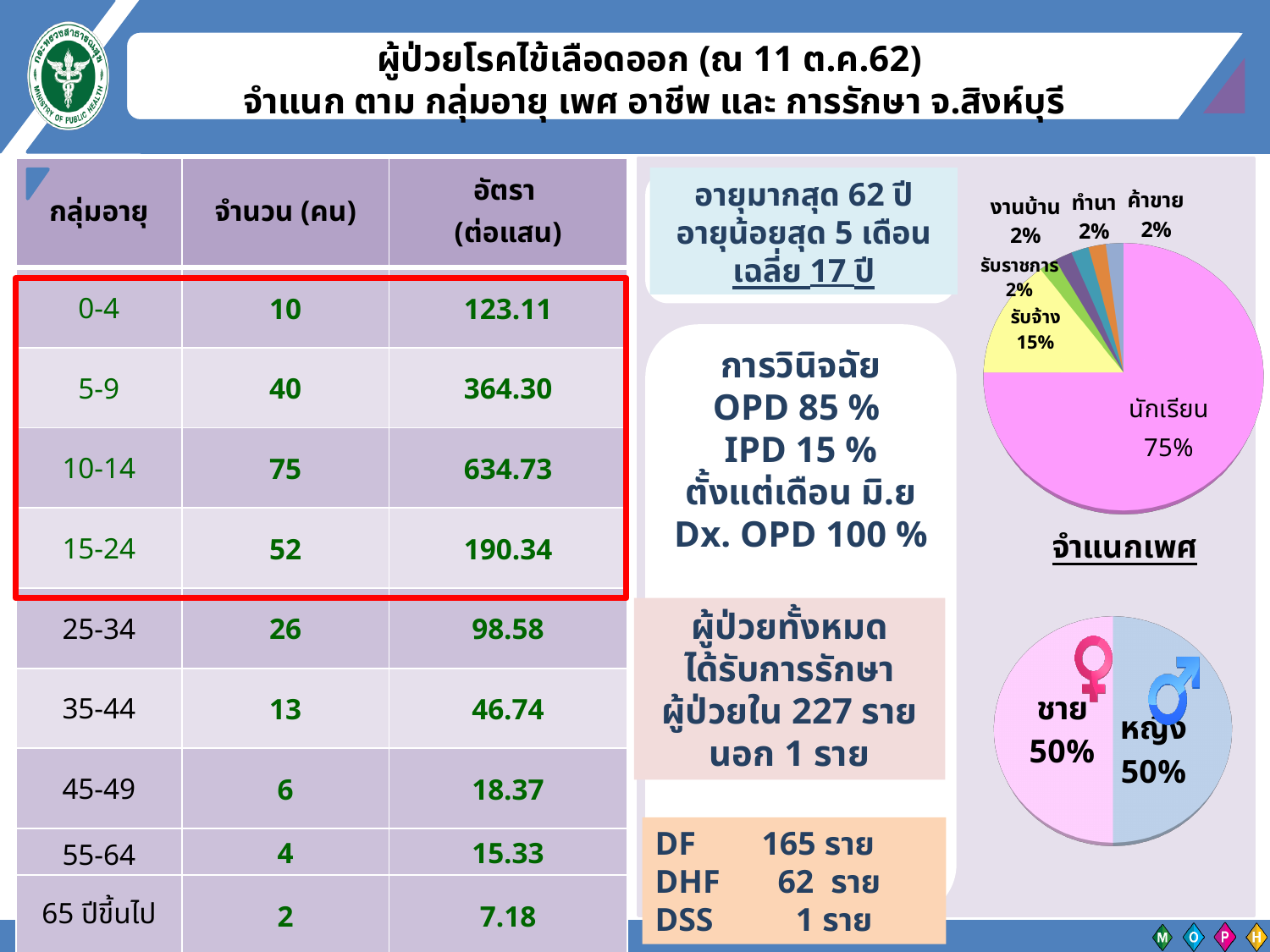
In the occupation pie chart (top right), what share is labelled for ค้าขาย? 2% In the gender pie chart (bottom right, จำแนกเพศ), what share is labelled for ชาย? 50% In the occupation pie chart (top right), what share is labelled for รับจ้าง? 15% How many slices does the gender pie chart (bottom right, จำแนกเพศ) have? 2 What is the title shown above the gender pie chart at the bottom right of the slide? จำแนกเพศ In the occupation pie chart (top right), what share is labelled for นักเรียน? 75% In the gender pie chart (bottom right, จำแนกเพศ), what share is labelled for หญิง? 50% What kind of chart is the chart at the top right of the slide? Pie chart In the occupation pie chart (top right), which is larger, the share for รับจ้าง or the share for งานบ้าน? รับจ้าง In the occupation pie chart (top right), what is the difference between the shares for นักเรียน and รับจ้าง? 60% In the occupation pie chart (top right), which category has the largest slice? นักเรียน How many slices does the occupation pie chart (top right) have? 7